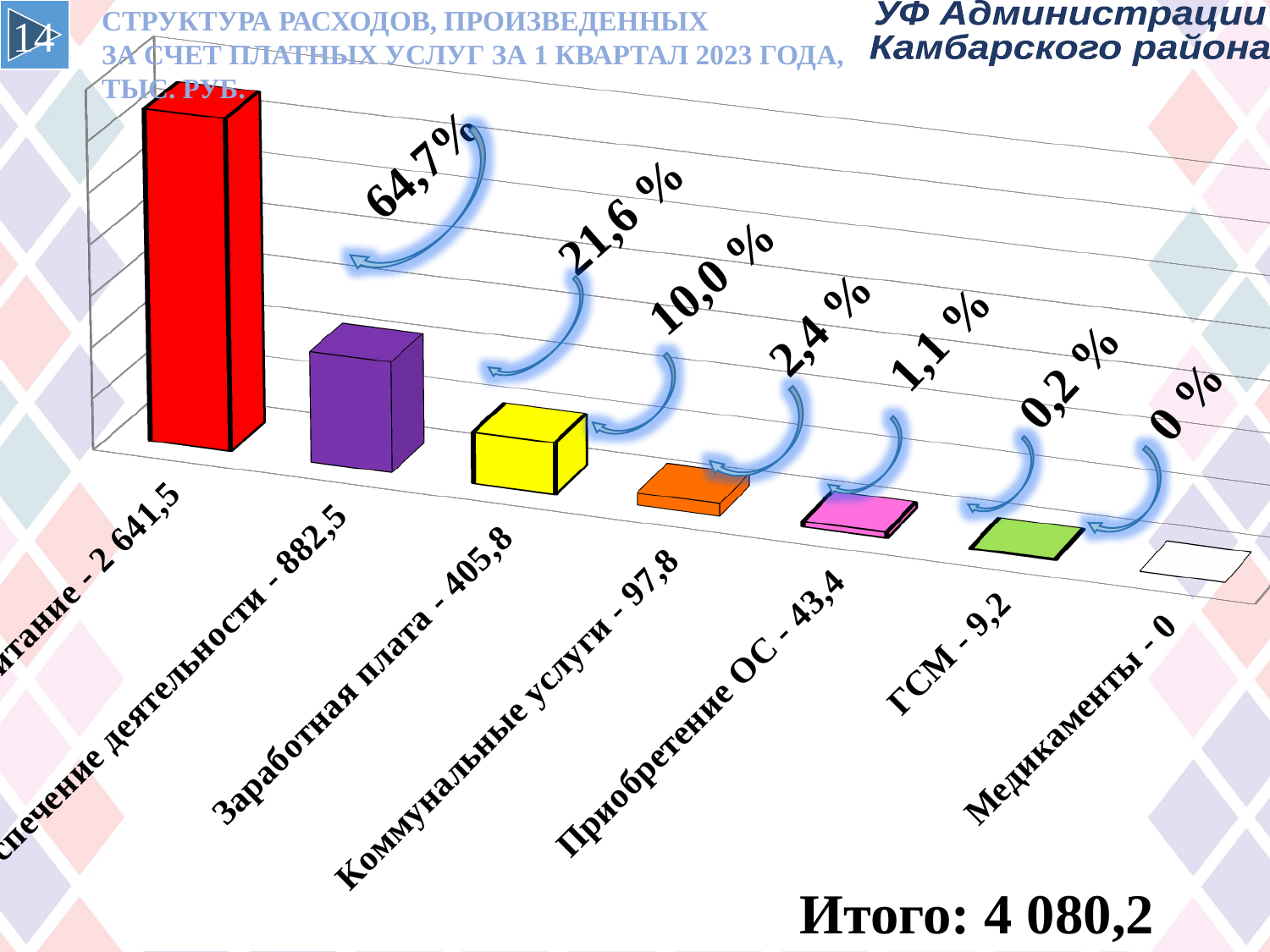
What is the value for Заработная плата? 405,8 What percentage share is shown for Коммунальные услуги? 2,4 % What is the value of the tallest (red) bar? 2 641,5 What is the difference between the values for Заработная плата and Коммунальные услуги? 308,0 What is the value for Коммунальные услуги? 97,8 Which category has the lowest value? Медикаменты What percentage share is shown for Заработная плата? 10,0 % What kind of chart is shown on the slide? bar chart What is the value for ГСМ? 9,2 What is the value for Приобретение ОС? 43,4 How many categories are shown in the chart? 7 Which is larger, the value for Приобретение ОС or for ГСМ? Приобретение ОС